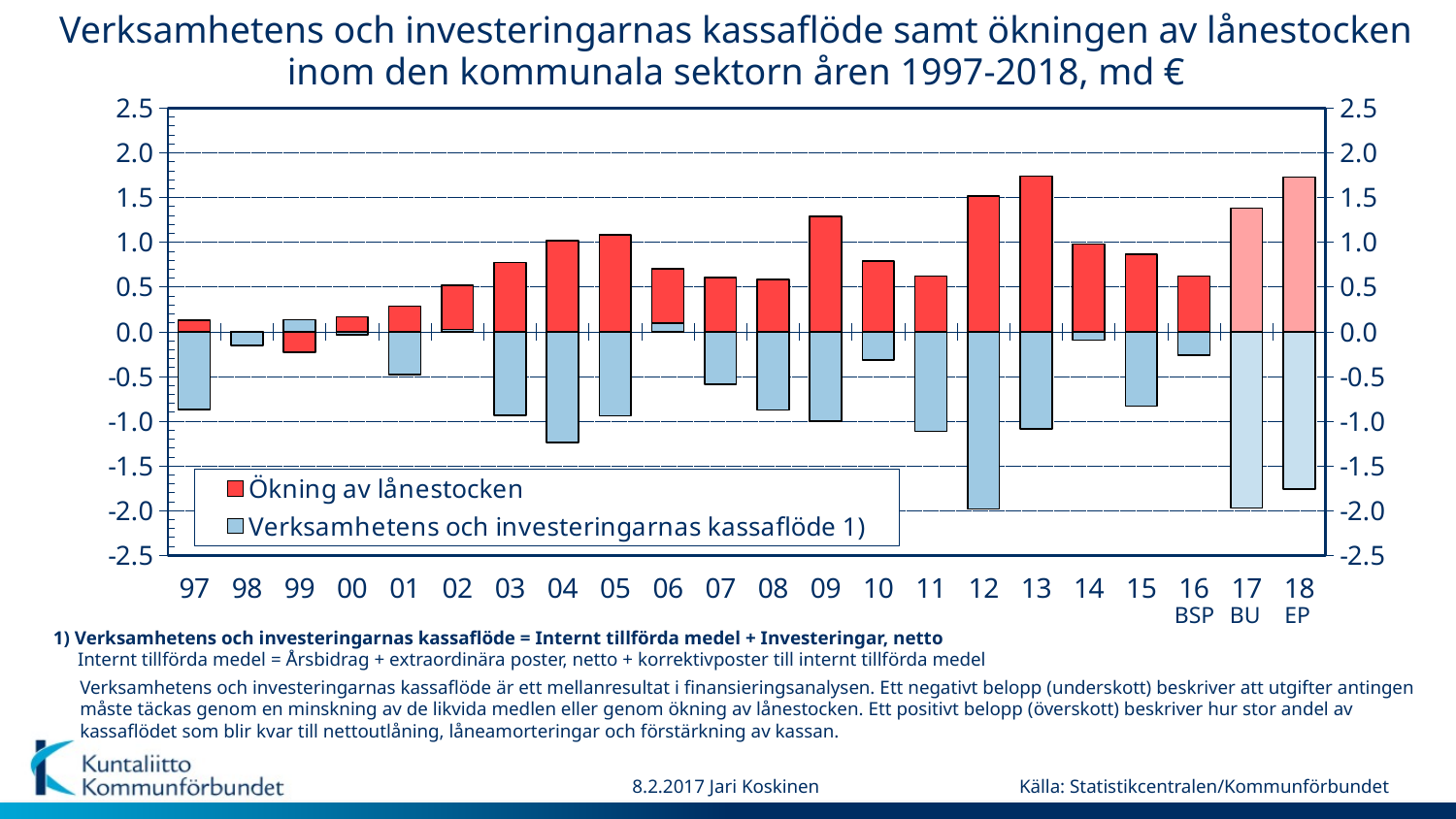
Which year has the larger value of Ökning av lånestocken, 08 or 12? 12 Is the value of Ökning av lånestocken for 13 greater or less than 1.5? greater Is the value of Verksamhetens och investeringarnas kassaflöde for 04 greater or less than -1.0? less Is the value of Ökning av lånestocken for 09 greater or less than 1.0? greater How many years are shown on the x axis? 22 What kind of chart is shown on the slide? bar chart How many series does the legend list? 2 Which year has the lower value of Verksamhetens och investeringarnas kassaflöde, 04 or 10? 04 What is the last year label on the x axis? 18 Which series is drawn in red? Ökning av lånestocken